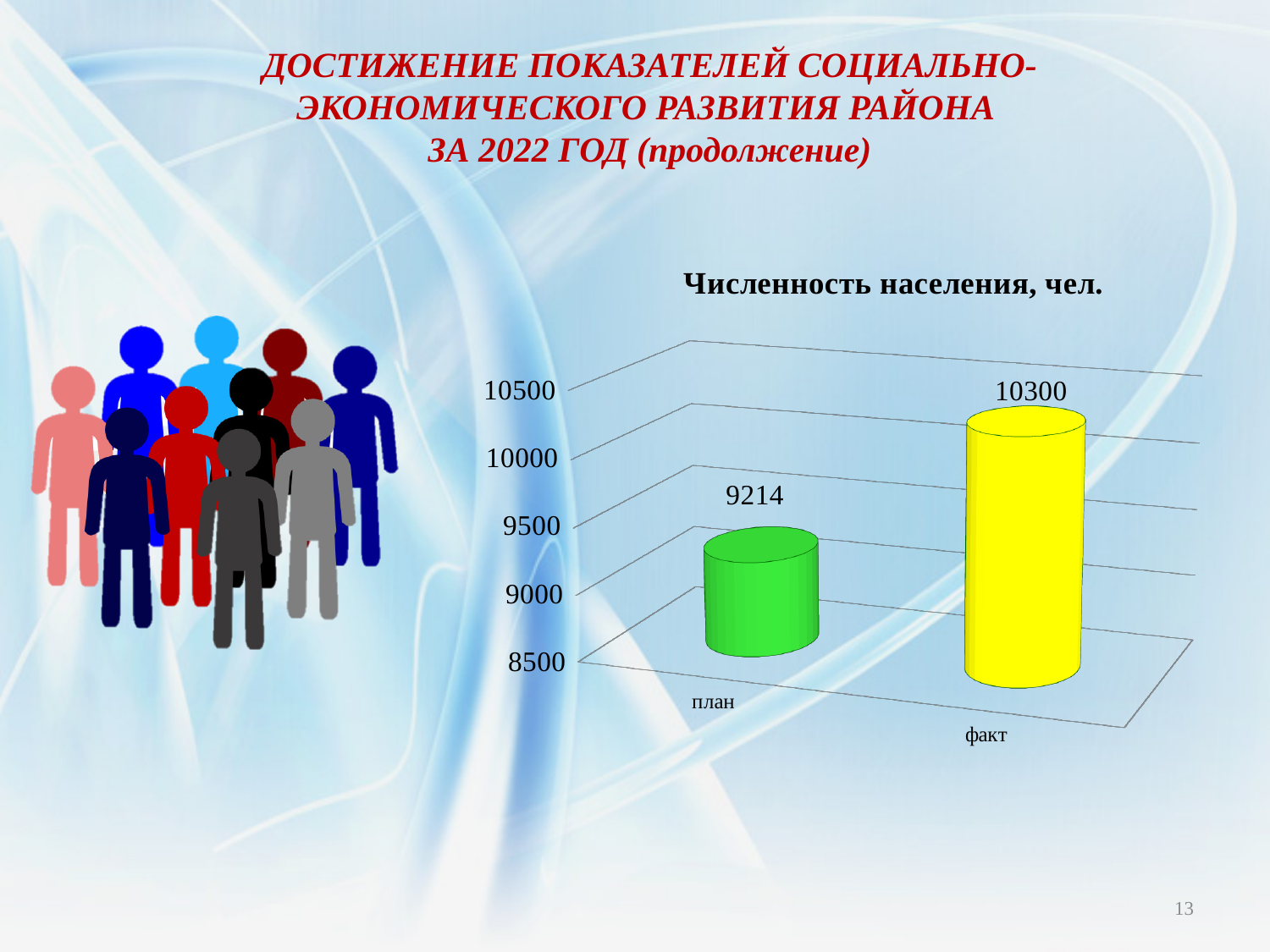
Do the values rise or fall from план to факт? rise What kind of chart is shown on the slide? bar chart What is the value for факт (actual) in the chart? 10300 What colour is the bar for факт? yellow Is the value for план greater or less than 9500? less Which category has the higher value, план or факт? факт What is the difference between the факт and план values? 1086 Is the value for факт greater or less than 10000? greater How many categories are shown in the chart? 2 Which category has the lowest value in the chart? план What is the value for план (plan) in the chart? 9214 What is the title of the chart? Численность населения, чел.